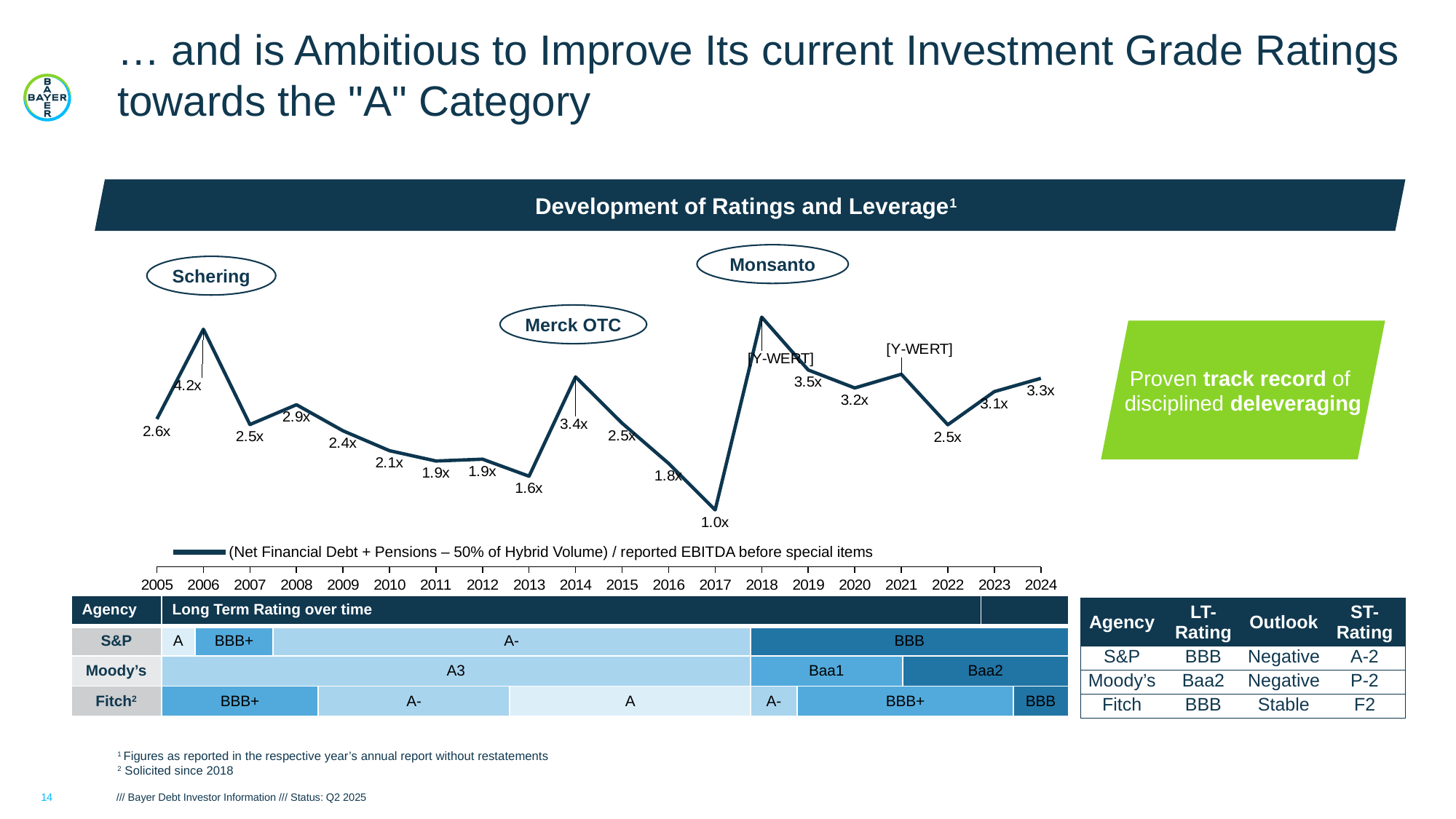
What is the leverage value shown for 2017? 1.0x What is the difference between the leverage values for 2006 and 2005? 1.6x How many years are shown on the x axis of the chart? 20 Which year has the lowest leverage value on the chart? 2017 What type of chart is used in 'Development of Ratings and Leverage'? line chart What is the leverage value shown for 2014? 3.4x What is the leverage value shown for 2006? 4.2x Which acquisition is annotated above the 2018 peak of the chart? Monsanto Which year has the larger leverage value, 2019 or 2020? 2019 Do the leverage values rise or fall from 2008 to 2013? fall What is the difference between the leverage values for 2014 and 2013? 1.8x What is the leverage value shown for 2024? 3.3x